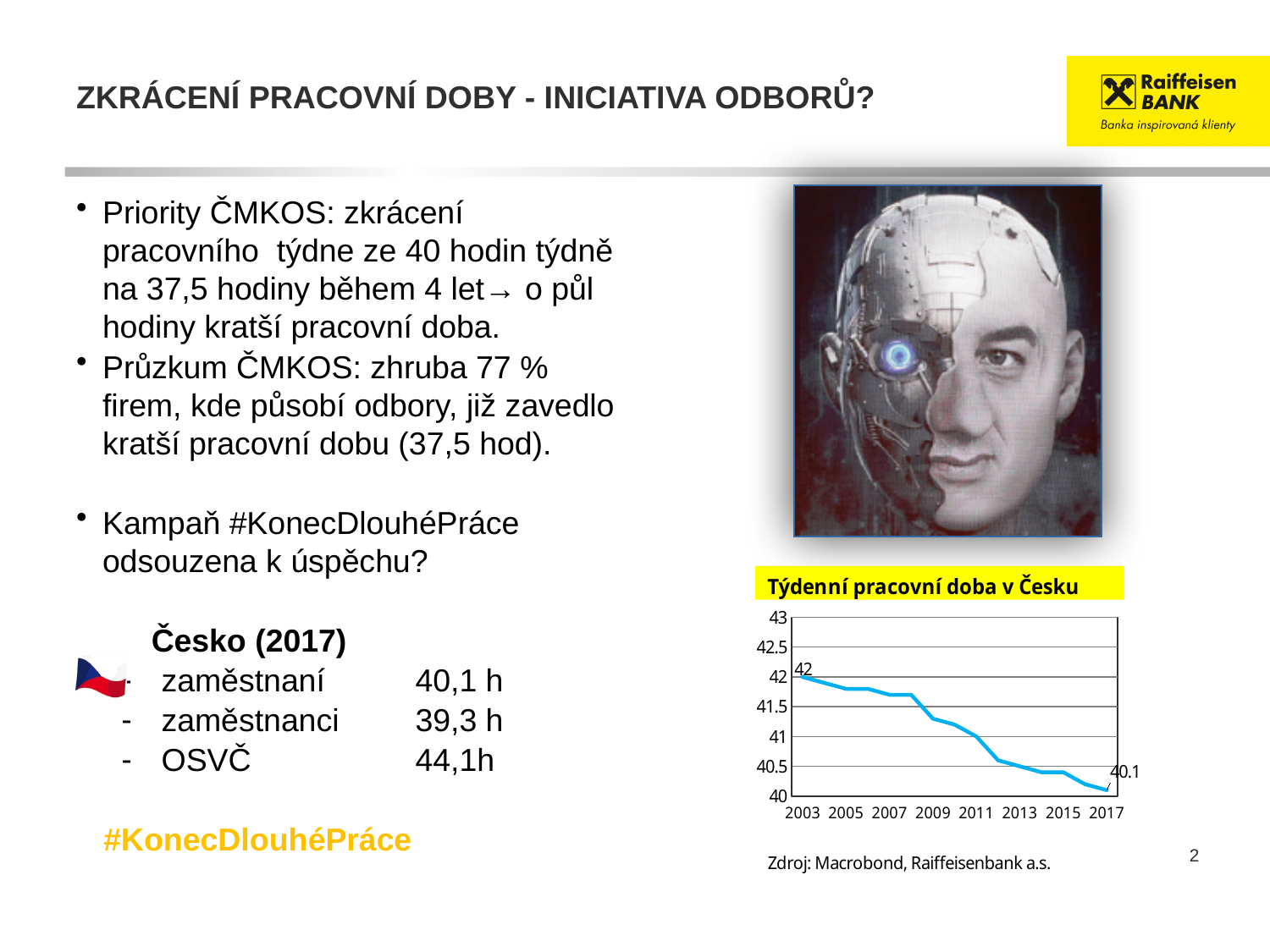
Is the value for 2009 greater or less than 41.5? less What is the difference between the 2003 value and the 2017 value in the chart? 1.9 In which year is the weekly working time highest in the chart? 2003 Which is larger in the chart, the value for 2003 or the value for 2017? 2003 In which year is the weekly working time lowest in the chart? 2017 What is the source given below the chart? Macrobond, Raiffeisenbank a.s. Do the values in the chart rise or fall from 2003 to 2017? fall What value does the chart show for 2003? 42 What value does the chart show for 2017? 40.1 Is the value for 2005 greater or less than 41.5? greater What is the title of the chart on the slide? Týdenní pracovní doba v Česku What kind of chart is shown under the title 'Týdenní pracovní doba v Česku'? line chart